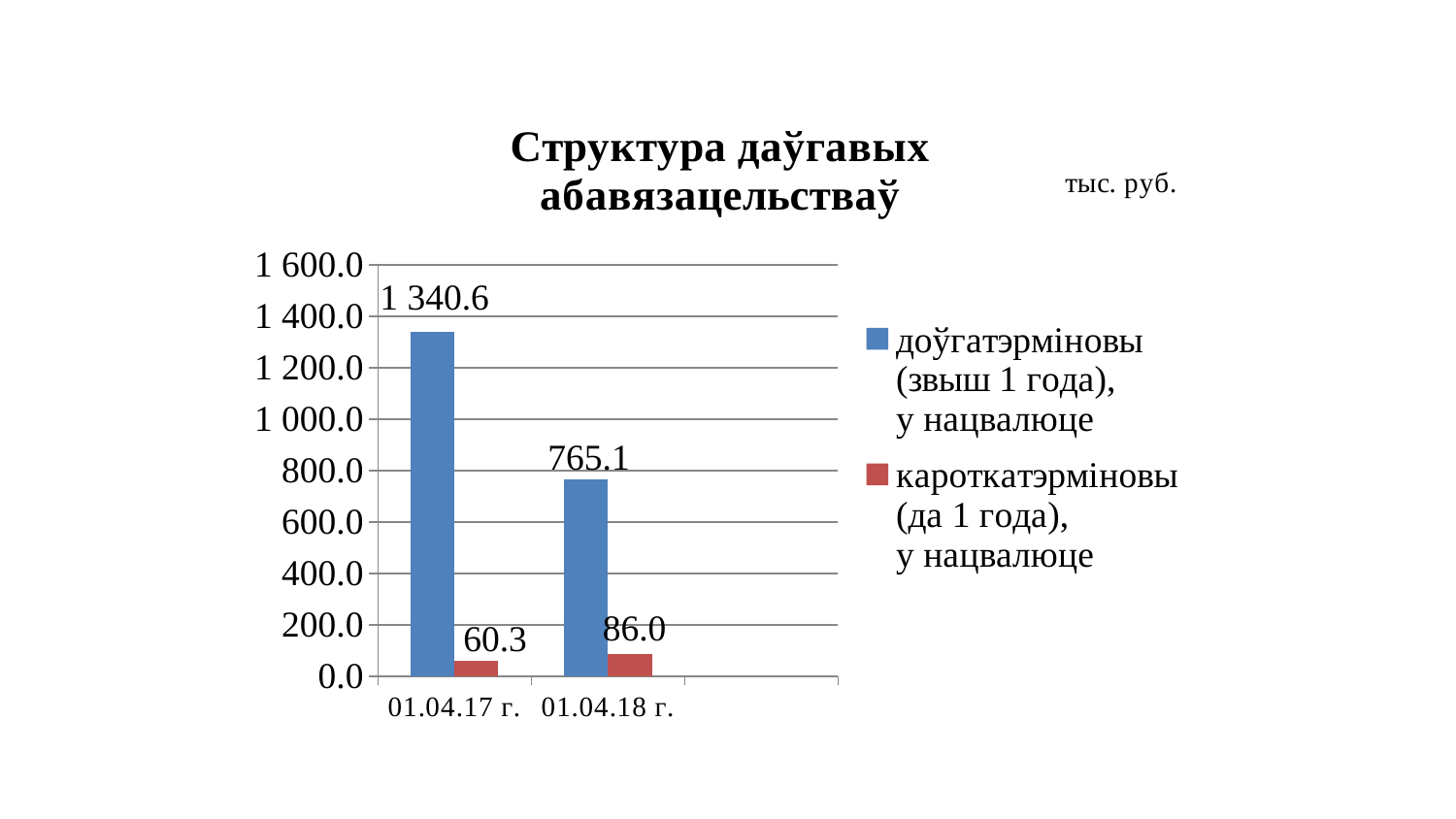
Which date has the higher value for the long-term (доўгатэрміновы) series? 01.04.17 г. What is the value of the long-term (доўгатэрміновы) series for 01.04.18 г.? 765.1 What is the value of the long-term (доўгатэрміновы) series for 01.04.17 г.? 1 340.6 What kind of chart is shown on the slide? Bar chart By how much did the long-term (доўгатэрміновы) value fall from 01.04.17 г. to 01.04.18 г.? 575.5 Which date has the lower value for the short-term (кароткатэрміновы) series? 01.04.17 г. What is the value of the short-term (кароткатэрміновы) series for 01.04.17 г.? 60.3 How many series does the legend list? 2 What is the difference between the short-term (кароткатэрміновы) values for 01.04.18 г. and 01.04.17 г.? 25.7 Is the long-term (доўгатэрміновы) value for 01.04.18 г. greater or less than 800.0? less What is the value of the short-term (кароткатэрміновы) series for 01.04.18 г.? 86.0 What unit is indicated next to the chart title? тыс. руб.